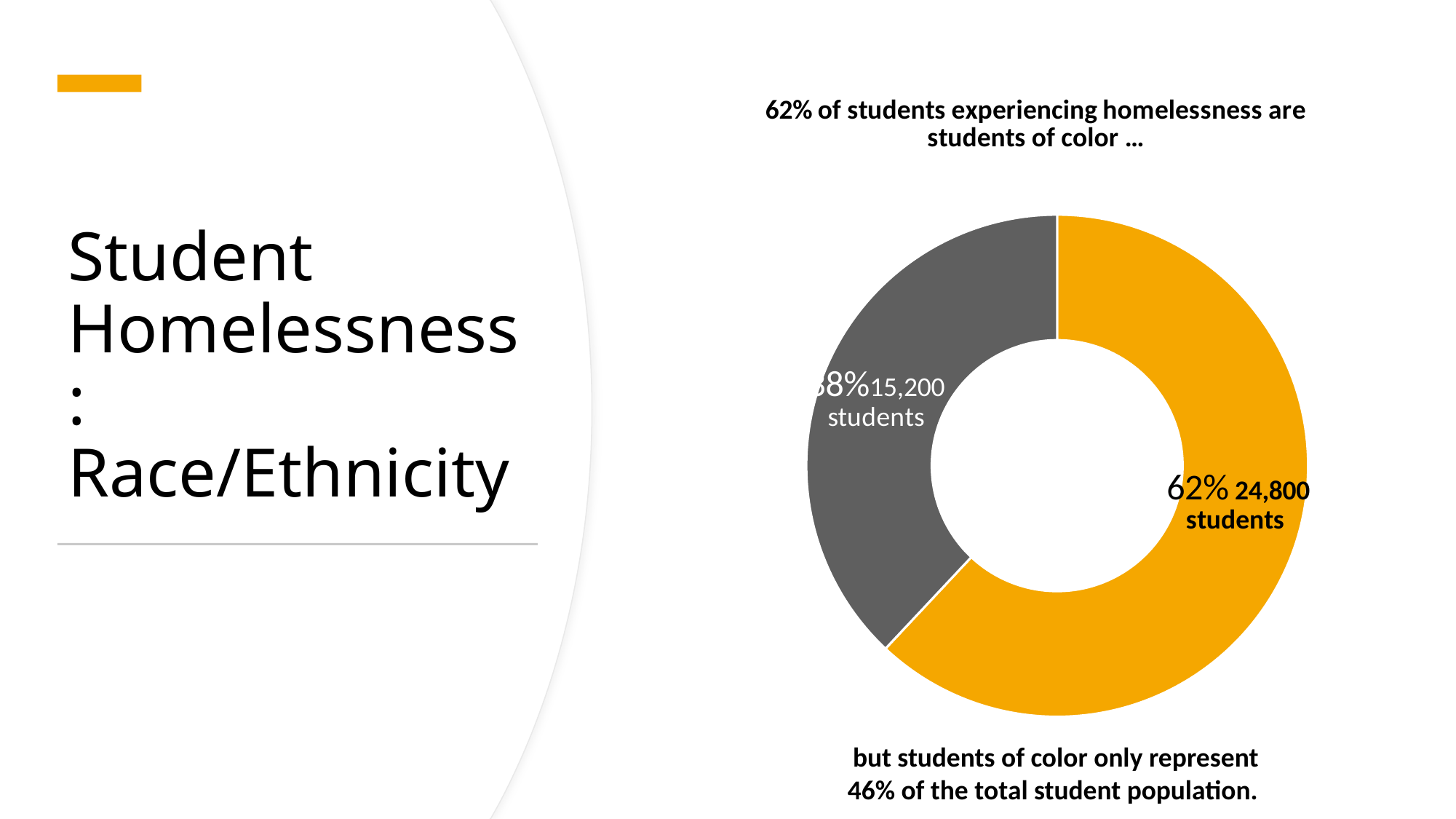
How many slices does the chart have? 2 What is the difference in number of students between the orange slice and the gray slice? 9,600 students Which slice represents the largest number of students? the orange slice (students of color), 24,800 students What share of the pie does the orange slice (students of color) make up? 62% According to the text below the chart, what percentage of the total student population do students of color represent? 46% What does the text above the chart say? 62% of students experiencing homelessness are students of color … Which slice is larger, the orange one or the gray one? the orange one What is the total number of students represented by both slices of the chart? 40,000 students How many students does the gray slice of the chart represent? 15,200 students How many students does the orange slice of the chart represent? 24,800 students What kind of chart is shown on the slide? pie chart (donut) What share of the pie does the gray slice make up? 38%